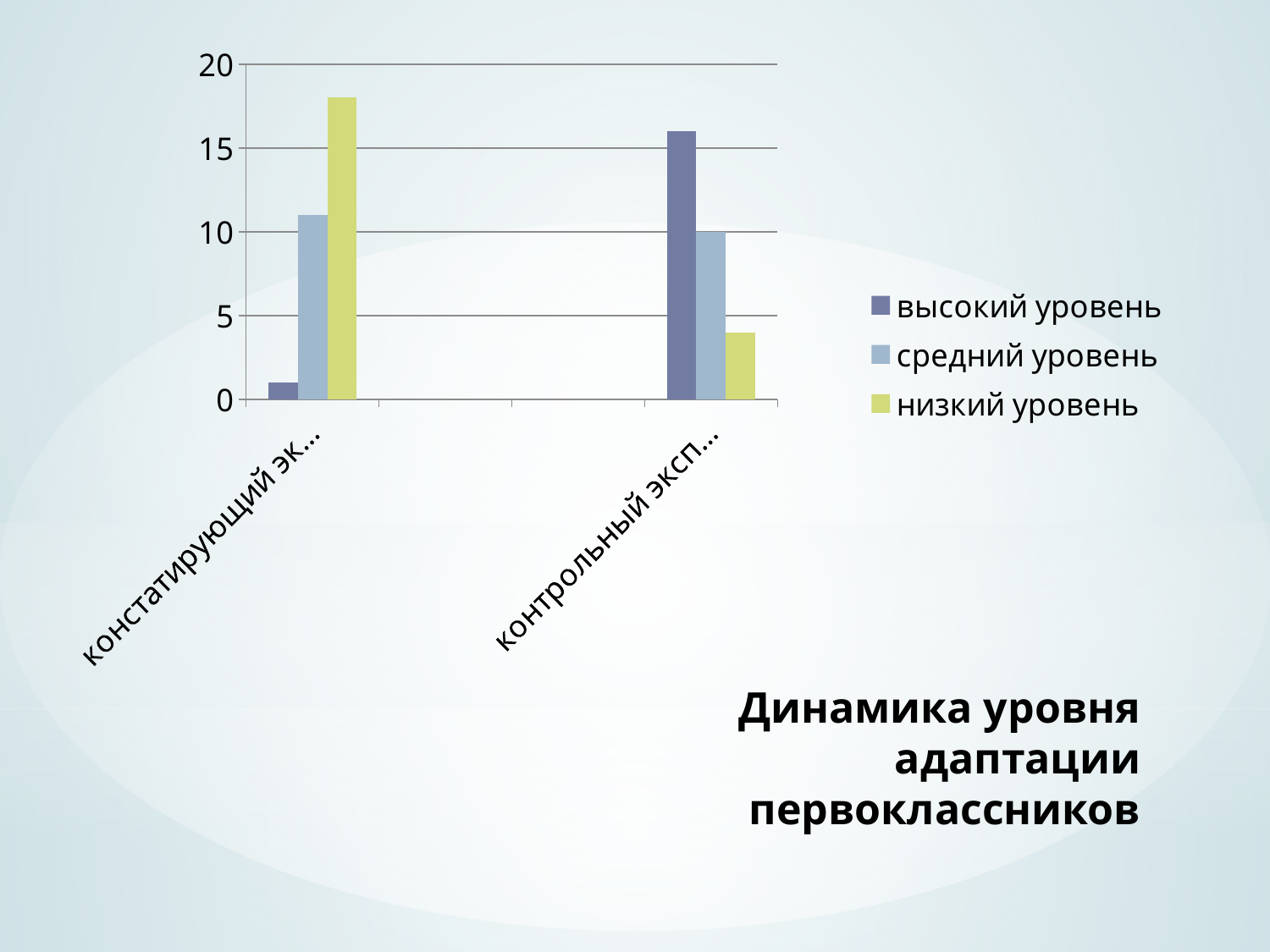
Which series has the highest bar in the first (left, констатирующий) category? низкий уровень Does the value for высокий уровень rise or fall from the first category to the second category? rise Which series has the lowest bar in the second (right, контрольный) category? низкий уровень Is the value for высокий уровень in the second (right, контрольный) category greater or less than 15? greater What kind of chart is shown on the slide? bar chart How many series does the legend list? 3 Is the value for высокий уровень in the first (left, констатирующий) category greater or less than 5? less Is the value for низкий уровень in the first (left, констатирующий) category greater or less than 15? greater In the second (right, контрольный) category, which is larger: высокий уровень or низкий уровень? высокий уровень How many categories are shown on the x axis? 2 In the first (left, констатирующий) category, which is larger: низкий уровень or средний уровень? низкий уровень